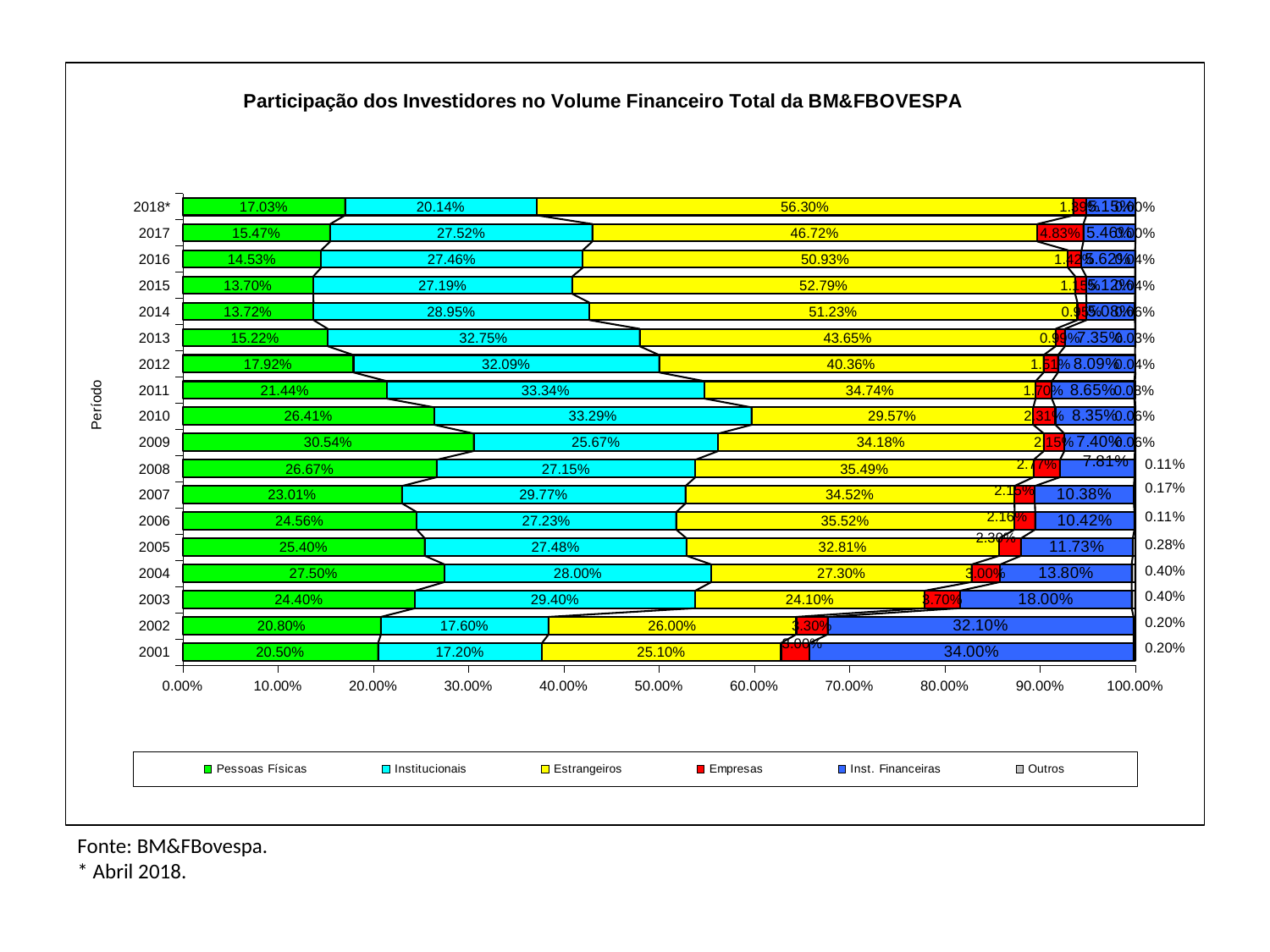
What kind of chart is shown? Stacked bar chart What is the Inst. Financeiras share for 2001? 34.00% In which period is the Estrangeiros share highest? 2018* What is the Estrangeiros share for 2018*? 56.30% In which period is the Pessoas Físicas share highest? 2009 How many series does the legend list? 6 What is the Pessoas Físicas share for 2009? 30.54% How many periods are shown on the chart? 18 What is the Institucionais share for 2014? 28.95% Does the Inst. Financeiras share rise or fall from 2001 to 2007? Fall What is the difference between the Estrangeiros share in 2018* and in 2017? 9.58% Which is larger, the Institucionais share in 2013 or in 2012? 2013